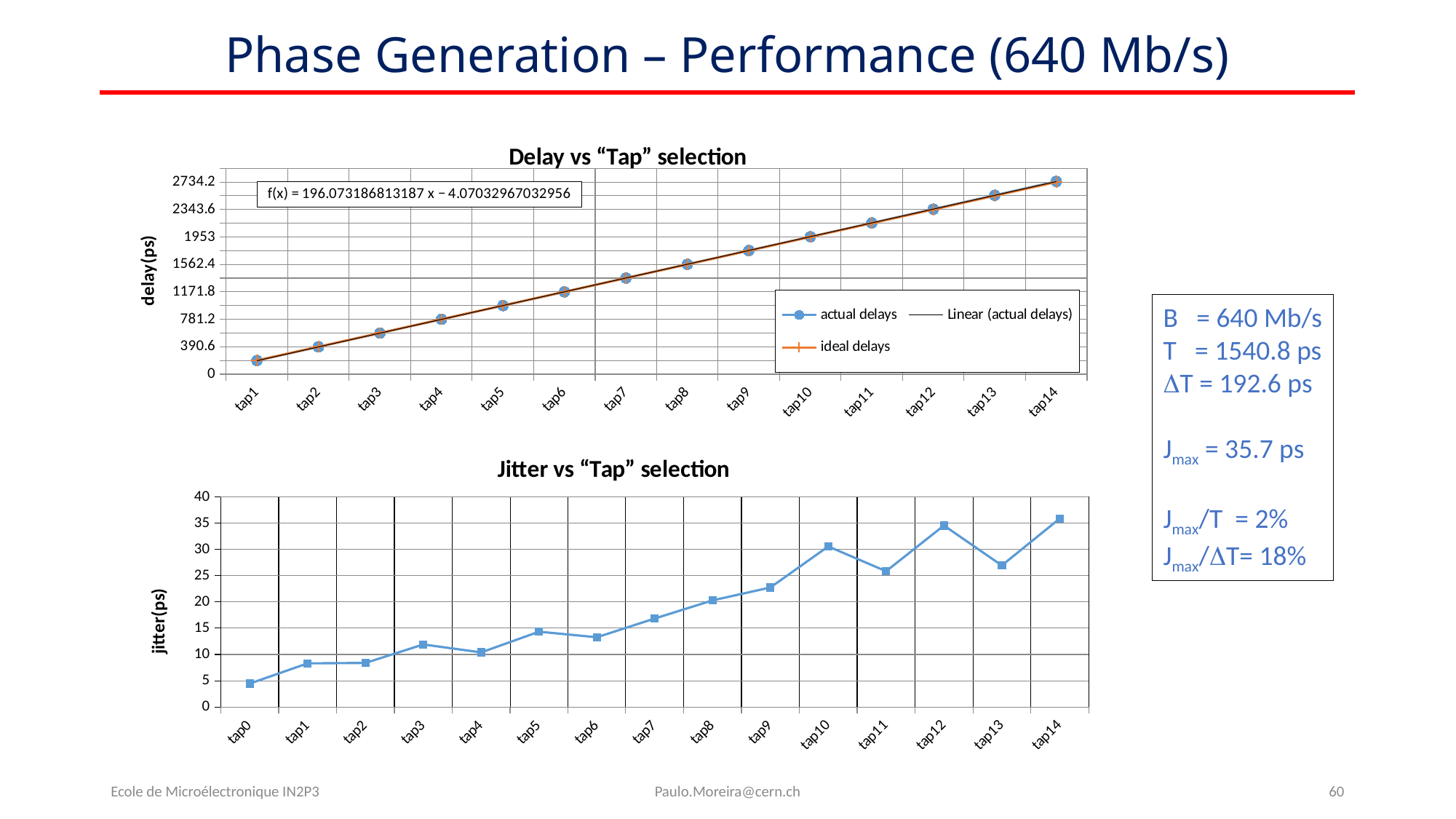
In the "Delay vs "Tap" selection" chart, is the actual delay for tap7 greater or less than 1171.8? greater In the "Jitter vs "Tap" selection" chart, which has the larger jitter, tap12 or tap13? tap12 In the "Jitter vs "Tap" selection" chart, which tap has the lowest jitter? tap0 How many tap categories are shown on the x axis of the "Jitter vs "Tap" selection" chart? 15 In the "Delay vs "Tap" selection" chart, is the actual delay for tap3 greater or less than 390.6? greater How many tap categories are shown on the x axis of the "Delay vs "Tap" selection" chart? 14 In the "Delay vs "Tap" selection" chart, which tap has the highest delay? tap14 How many series does the legend of the "Delay vs "Tap" selection" chart list? 3 What type of chart is the "Delay vs "Tap" selection" chart? line chart In the "Delay vs "Tap" selection" chart, do the delays rise or fall from tap1 to tap14? rise In the "Jitter vs "Tap" selection" chart, is the jitter for tap9 greater or less than 20? greater